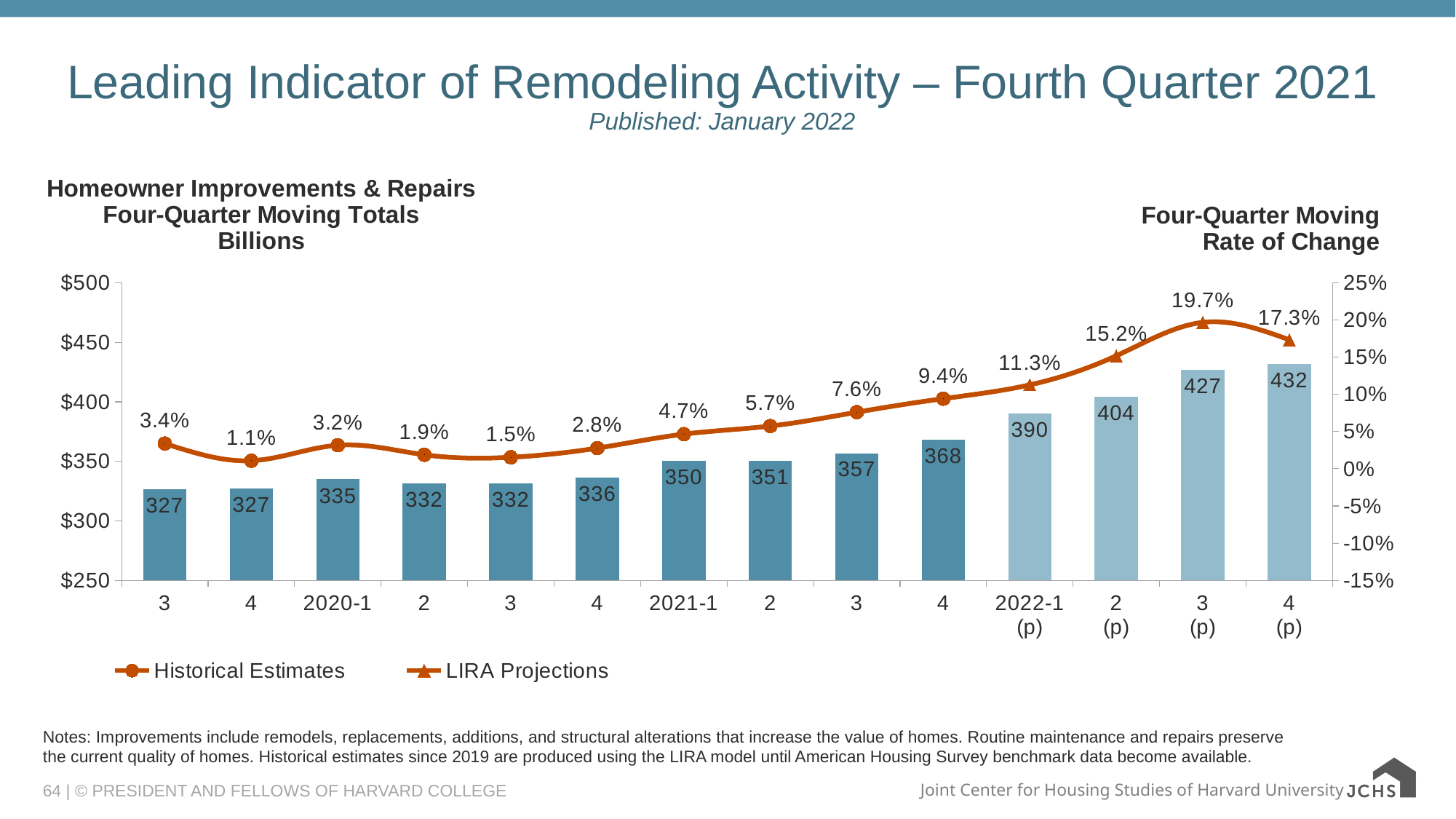
Is the four-quarter moving total for 2022-2 (p) greater or less than $400 billion? greater What is the projected four-quarter moving total for 2022-3 (p)? 427 Which is larger, the rate of change for 2022-4 (p) or for 2022-3 (p)? 2022-3 (p) What is the four-quarter moving total (in billions) for 2021-1? 350 Which quarter has the lowest four-quarter moving rate of change? 2019-4 How many quarters are shown on the x axis of the chart? 14 What is the difference between the four-quarter moving totals for 2022-4 (p) and 2021-4? 64 Do the four-quarter moving totals rise or fall from 2021-1 to 2022-4 (p)? rise What are the two series named in the legend? Historical Estimates and LIRA Projections What is the four-quarter moving rate of change for the fourth quarter of 2021? 9.4% Which quarter has the highest four-quarter moving rate of change? 2022-3 (p) How many series does the legend list? 2